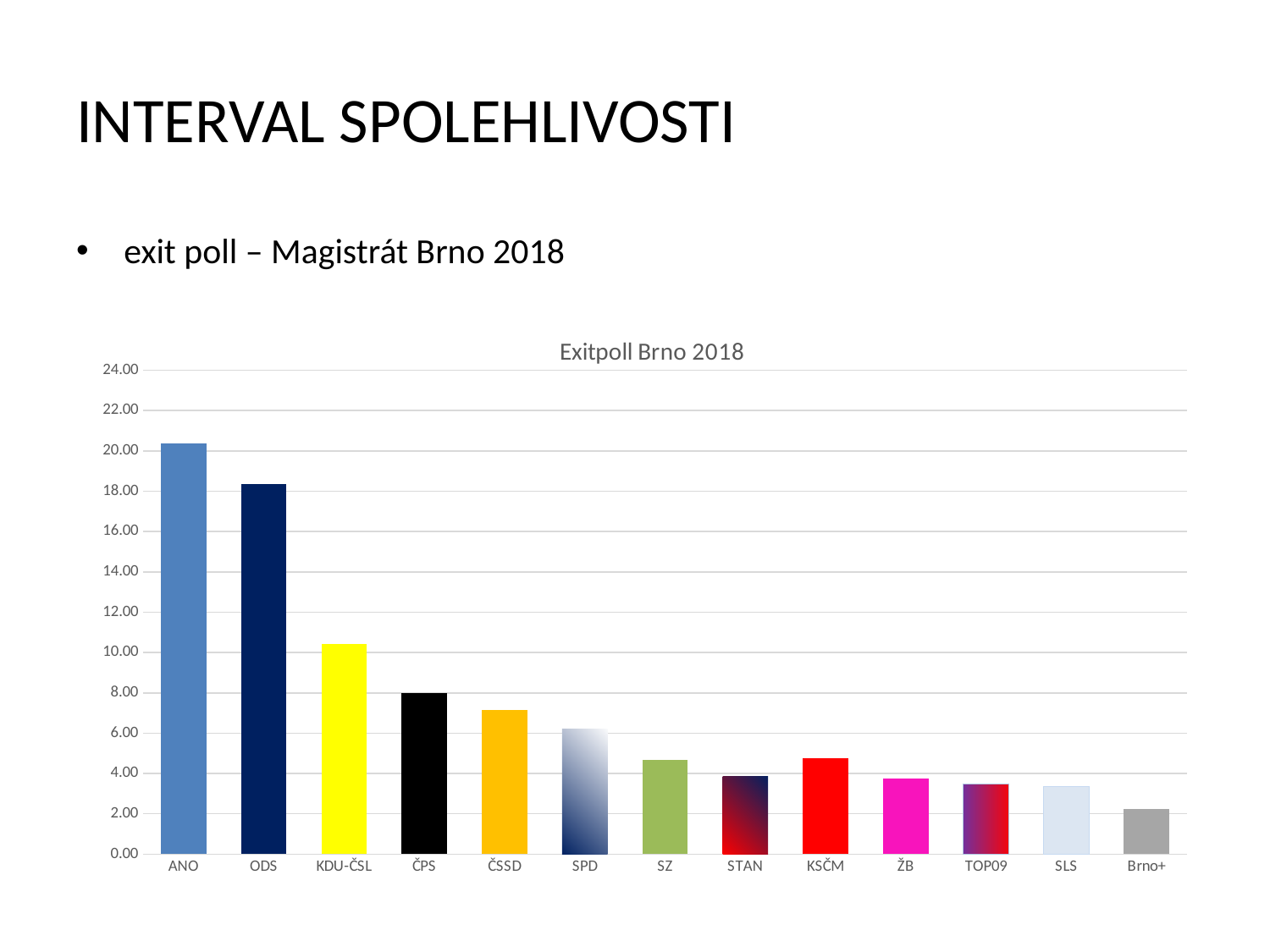
Which party has the highest value in the chart? ANO Is the value for KDU-ČSL greater or less than 12.00? less Is the value for ODS greater or less than 16.00? greater Is the value for SPD greater or less than 4.00? greater Which party has the lowest value in the chart? Brno+ What is the title of the chart? Exitpoll Brno 2018 Which has the larger value, ANO or ODS? ANO What kind of chart is shown on the slide? bar chart How many parties (categories) are shown on the x axis of the chart? 13 Which has the larger value, ČSSD or SPD? ČSSD